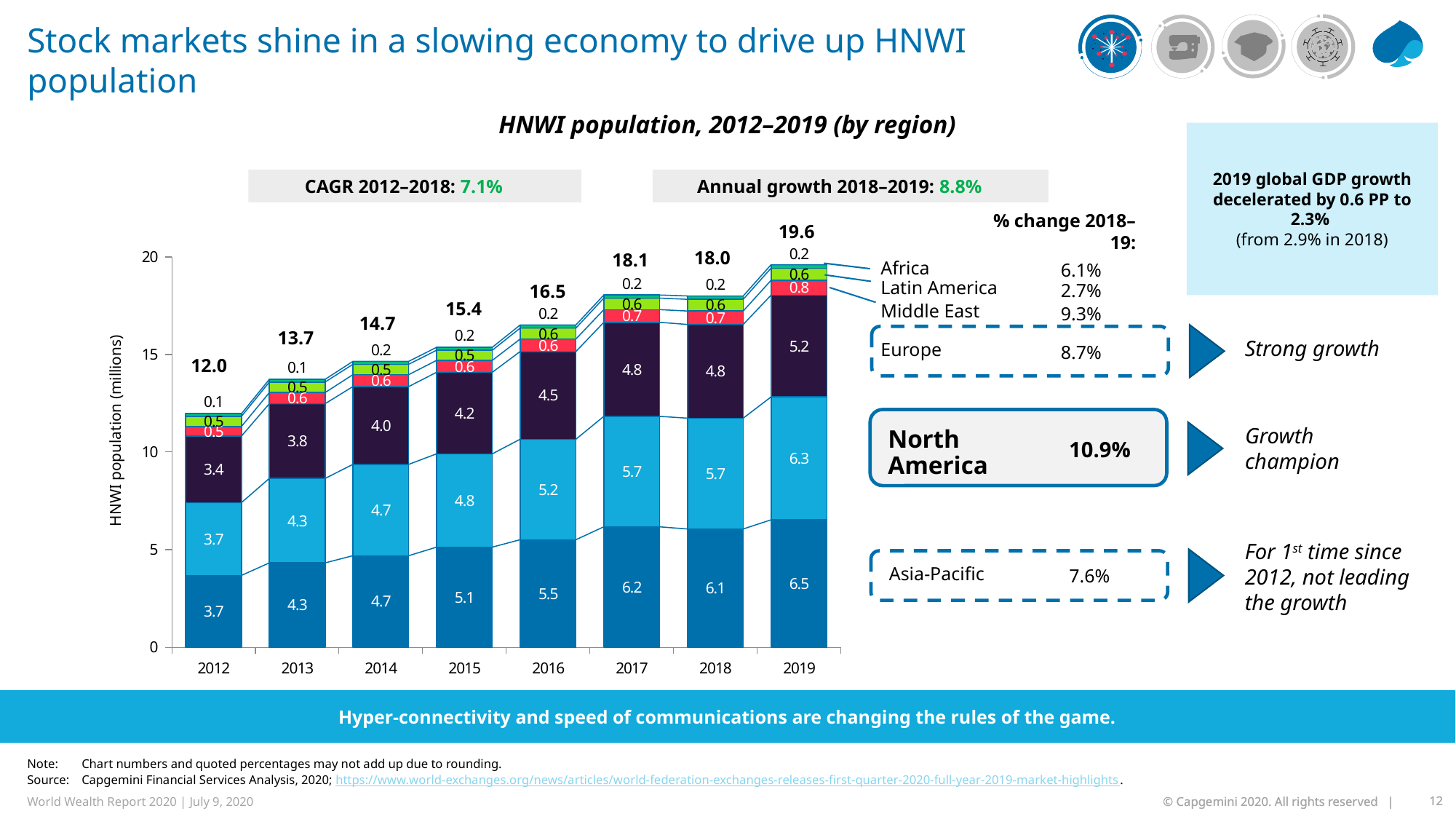
Which year has the highest total HNWI population? 2019 How many years are shown on the x axis of the chart? 8 What is the total HNWI population shown for 2019? 19.6 What is the Middle East HNWI population value shown for 2019? 0.8 What is the Europe HNWI population value shown for 2016? 4.5 Does the total HNWI population generally rise or fall from 2012 to 2019? Rise What kind of chart is used to show the HNWI population by region? Stacked bar chart What is the Asia-Pacific HNWI population value shown for 2019? 6.5 Which year has the lowest total HNWI population? 2012 What is the difference between the total HNWI population in 2019 and in 2018? 1.6 What is the North America HNWI population value shown for 2017? 5.7 In 2019, which is larger: the Asia-Pacific value or the North America value? Asia-Pacific